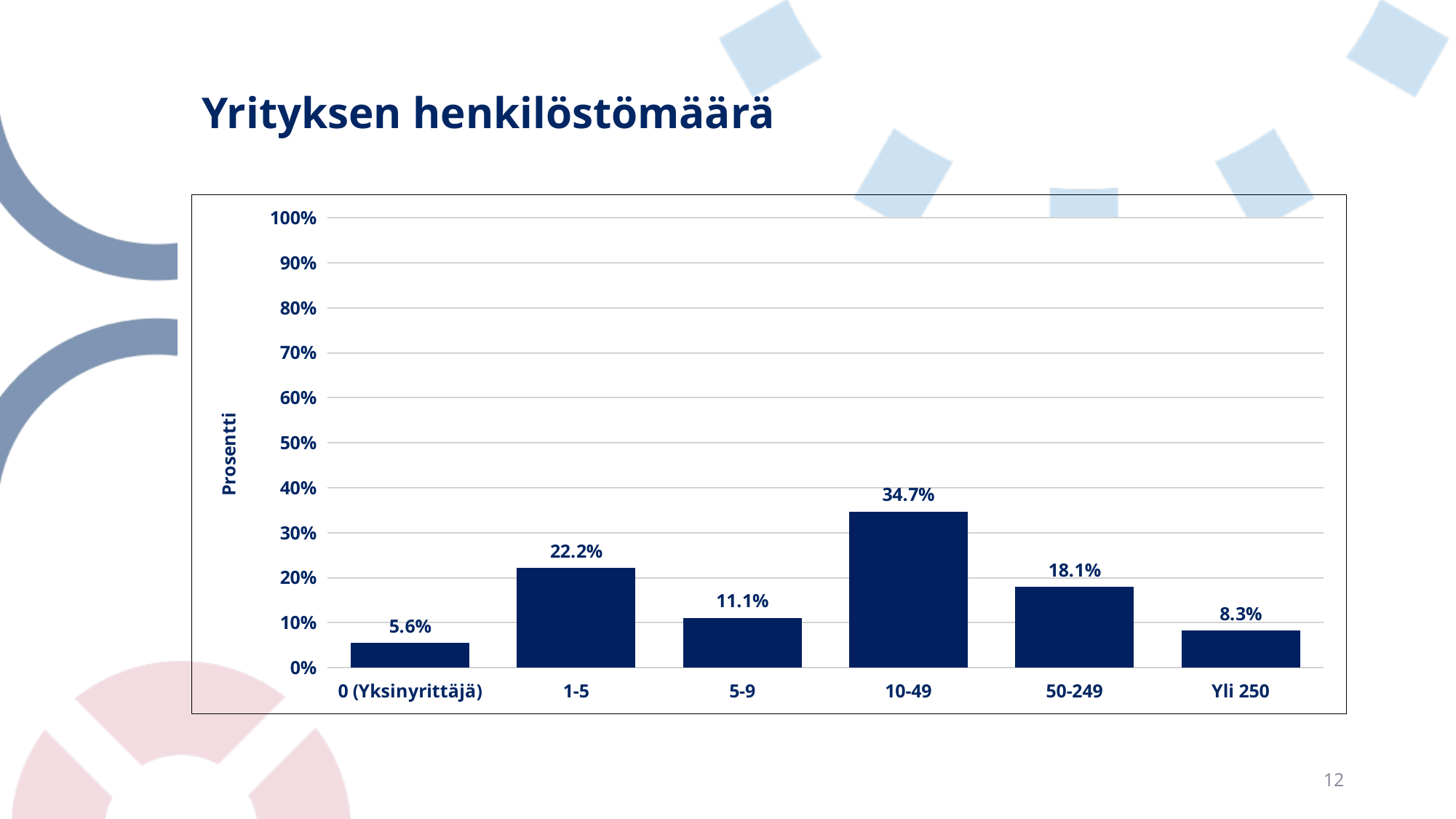
What is the difference between the values for 50-249 and Yli 250? 9.8% What is the value for the 0 (Yksinyrittäjä) category? 5.6% What kind of chart is shown on the slide? bar chart What is the difference between the values for 10-49 and 1-5? 12.5% How many categories are shown on the x axis? 6 Which is larger, the value for 1-5 or the value for 50-249? 1-5 Is the value for 5-9 greater or less than 20%? less What is the value for the Yli 250 category? 8.3% What is the value for the 10-49 category? 34.7% Which category has the lowest value? 0 (Yksinyrittäjä) Which category has the highest value? 10-49 What is the label of the vertical axis? Prosentti